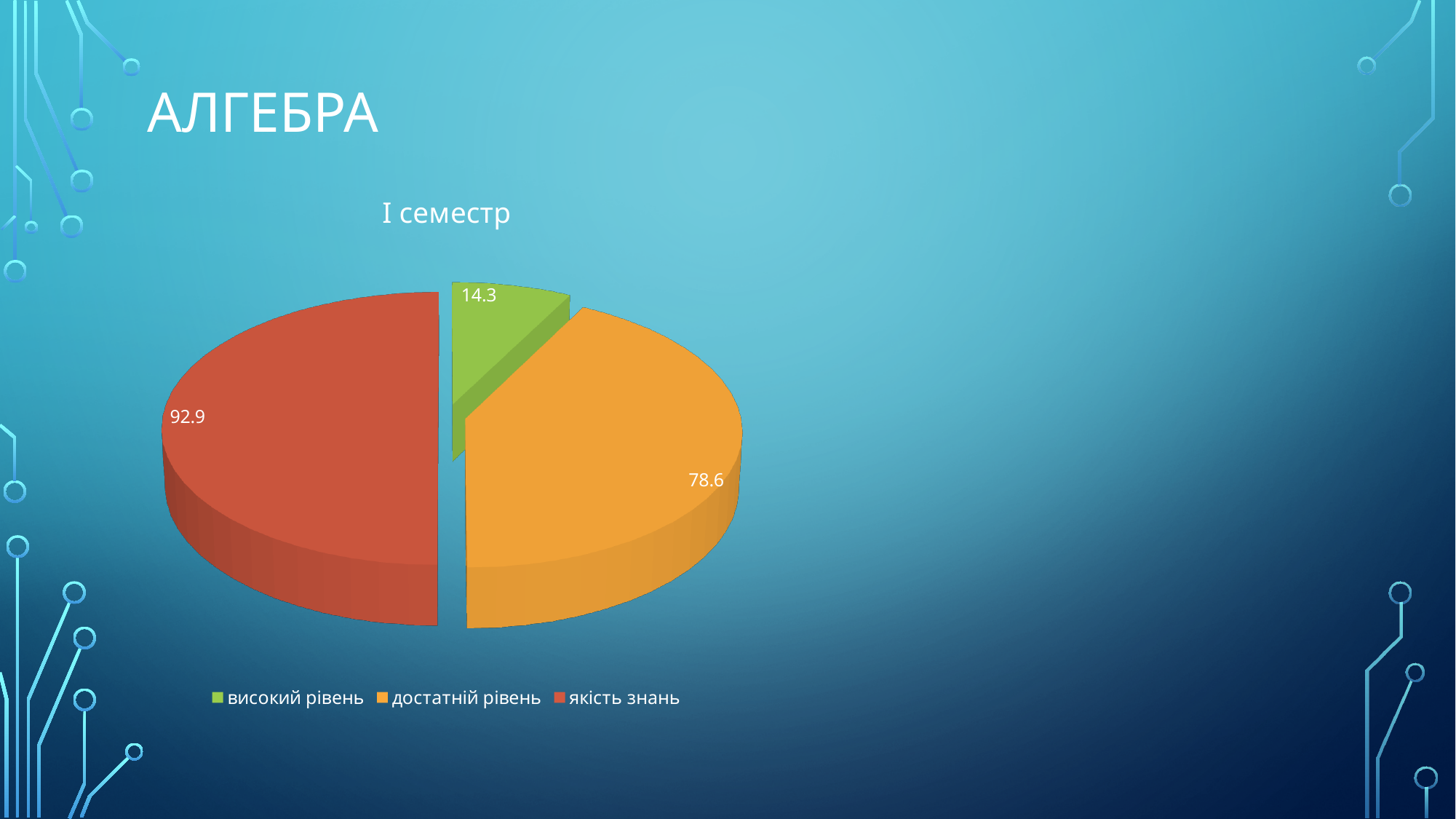
What is the value for високий рівень? 14.3 What is the difference between the values for достатній рівень and високий рівень? 64.3 Which colour represents якість знань in the legend? red What is the value for достатній рівень? 78.6 What is the title of the chart? I семестр What is the difference between the values for якість знань and достатній рівень? 14.3 Which is larger, the value for достатній рівень or the value for високий рівень? достатній рівень Which category has the largest slice? якість знань Which category has the smallest slice? високий рівень How many slices does the pie chart have? 3 What is the value for якість знань? 92.9 What kind of chart is shown on the slide? pie chart